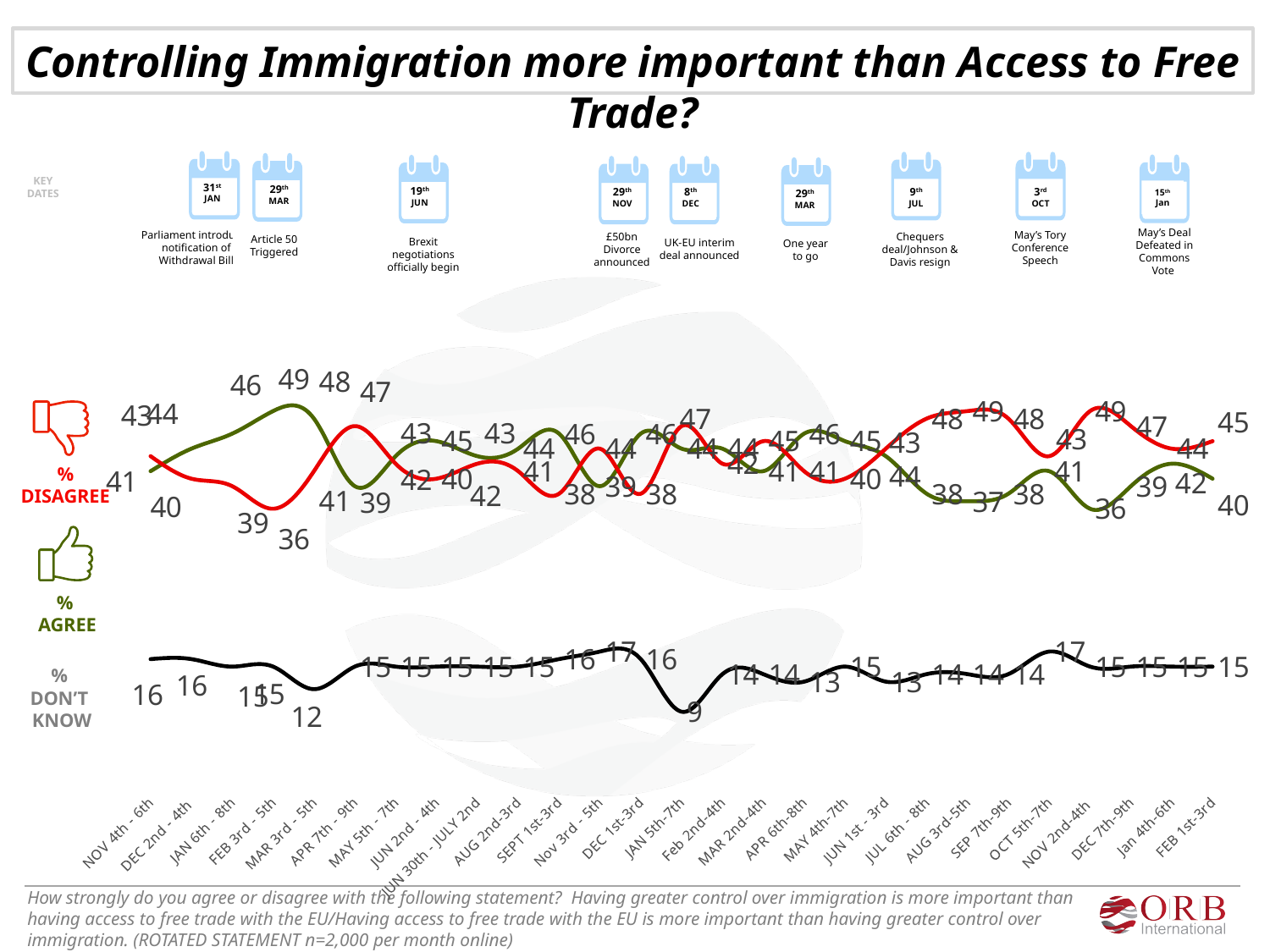
How many survey periods are shown along the x axis? 27 In which survey period is the % Don't Know value lowest? JAN 5th-7th What is the % Don't Know value for MAR 3rd-5th? 12 For FEB 3rd-5th, which is larger: % Agree or % Disagree? % Agree What is the % Disagree value for FEB 1st-3rd? 45 What colour is the % Agree line? green How many series does the chart plot? 3 What is the % Don't Know value for JAN 5th-7th? 9 For FEB 1st-3rd, what is the difference between % Disagree and % Agree? 5 What kind of chart is shown on the slide? line chart In which survey period is the % Agree value lowest? NOV 2nd-4th What is the % Agree value for FEB 3rd-5th? 49